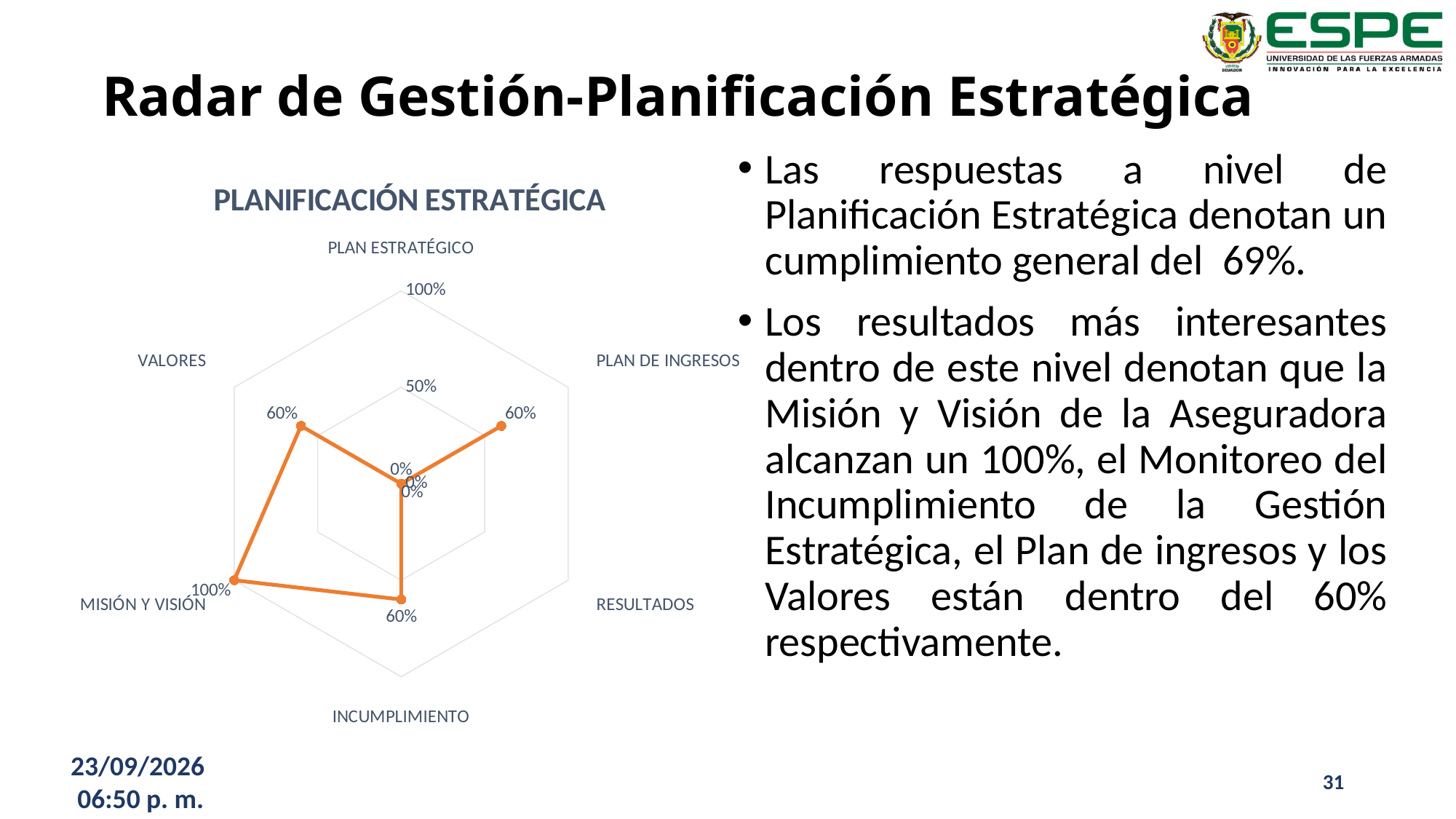
Is the value for PLAN DE INGRESOS in the radar chart greater or less than 50%? greater What is the value for PLAN ESTRATÉGICO in the radar chart? 0% What is the value for PLAN DE INGRESOS in the radar chart? 60% What type of chart is shown under the title PLANIFICACIÓN ESTRATÉGICA? Radar chart What is the difference between the values for MISIÓN Y VISIÓN and VALORES in the radar chart? 40% Which is larger in the radar chart, the value for MISIÓN Y VISIÓN or the value for INCUMPLIMIENTO? MISIÓN Y VISIÓN How many categories (axes) does the radar chart have? 6 What is the value for MISIÓN Y VISIÓN in the radar chart? 100% Which category has the highest value in the radar chart? MISIÓN Y VISIÓN What is the title of the radar chart? PLANIFICACIÓN ESTRATÉGICA What is the value for VALORES in the radar chart? 60% What is the value for INCUMPLIMIENTO in the radar chart? 60%